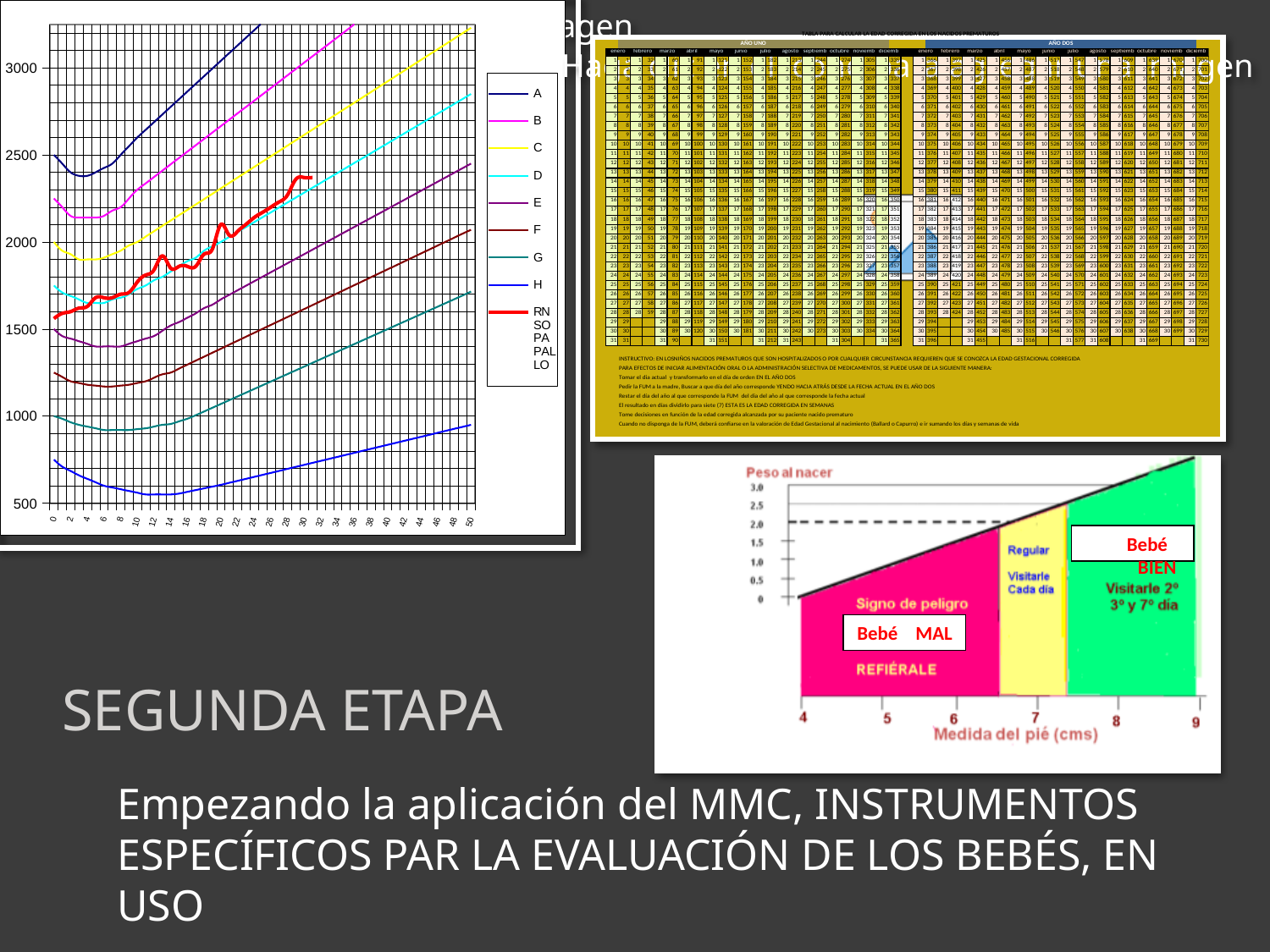
What is the x-axis title of the chart at the bottom right of the slide? Medida del pié (cms) In the chart on the left, is the value of series H at x = 0 greater or less than 1000? less In the chart on the left, is the value of series F at x = 0 greater or less than 1000? greater What kind of chart is the chart on the left of the slide? line chart In the chart on the left, what colour is the line for the series RN SO PA PAL LO? red How many series does the legend of the chart on the left list? 9 In the chart on the left, is the value of series B at x = 0 greater or less than 2000? greater In the chart on the left, which series is plotted lowest across the whole x axis? H